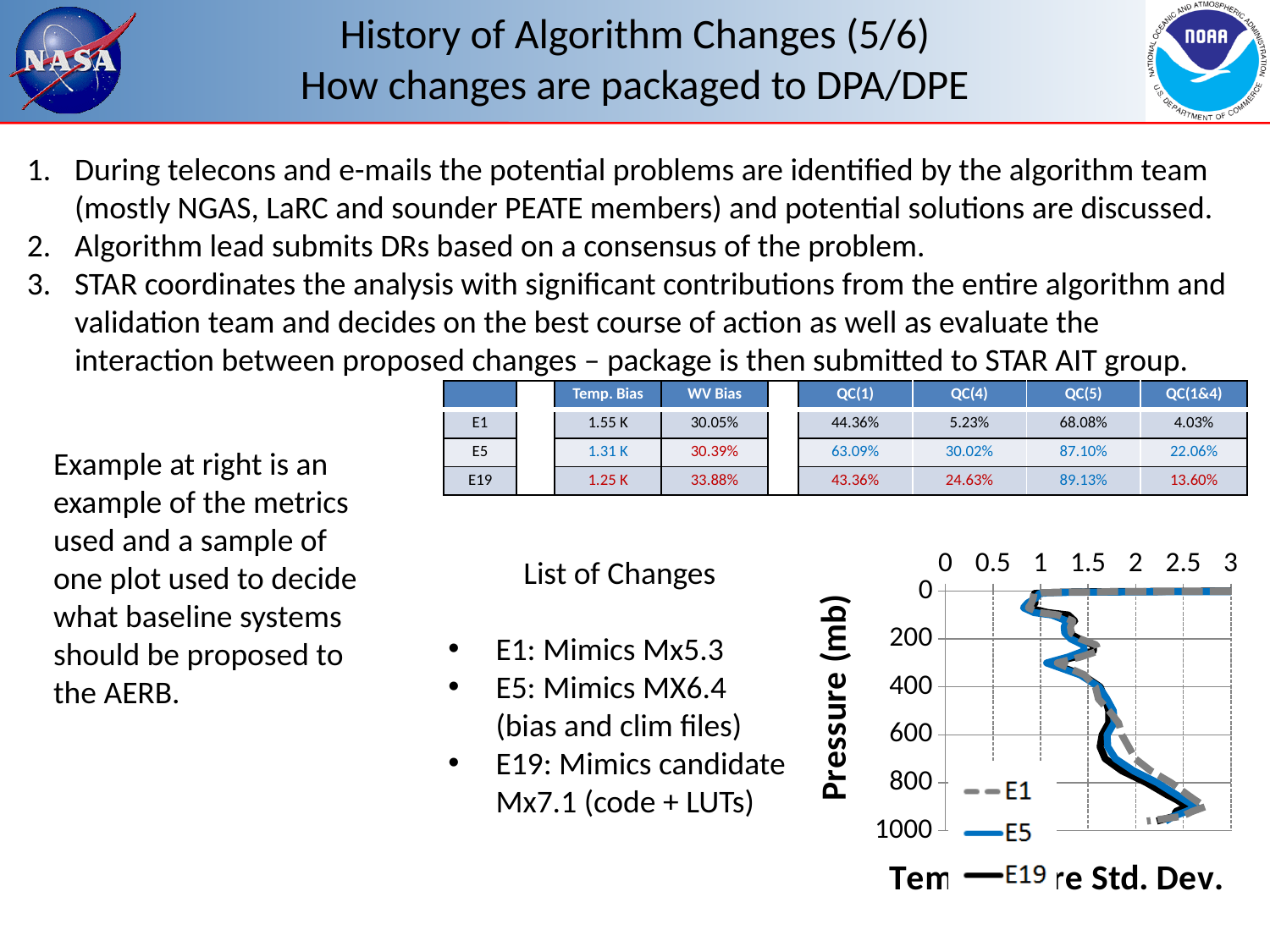
In the chart at the bottom right, is the E1 value at 400 mb greater or less than 1? greater What is the largest value shown on the horizontal axis of the chart at the bottom right? 3 In the chart at the bottom right, does the temperature standard deviation generally increase or decrease as pressure goes from 0 mb to 1000 mb? increase How many tick labels are shown on the horizontal axis of the chart at the bottom right? 7 In the chart at the bottom right, is the E19 value at around 900 mb greater or less than 2? greater What is the title of the vertical axis of the chart at the bottom right? Pressure (mb) What kind of chart is shown at the bottom right of the slide? line chart In the chart at the bottom right, which series is drawn with a dashed line? E1 What are the names of the series in the legend of the chart at the bottom right? E1, E5, E19 How many series does the legend of the Temperature Std. Dev. chart list? 3 In the chart at the bottom right, is the E5 value at 200 mb greater or less than 2? less What is the largest pressure value shown on the vertical axis of the chart at the bottom right? 1000